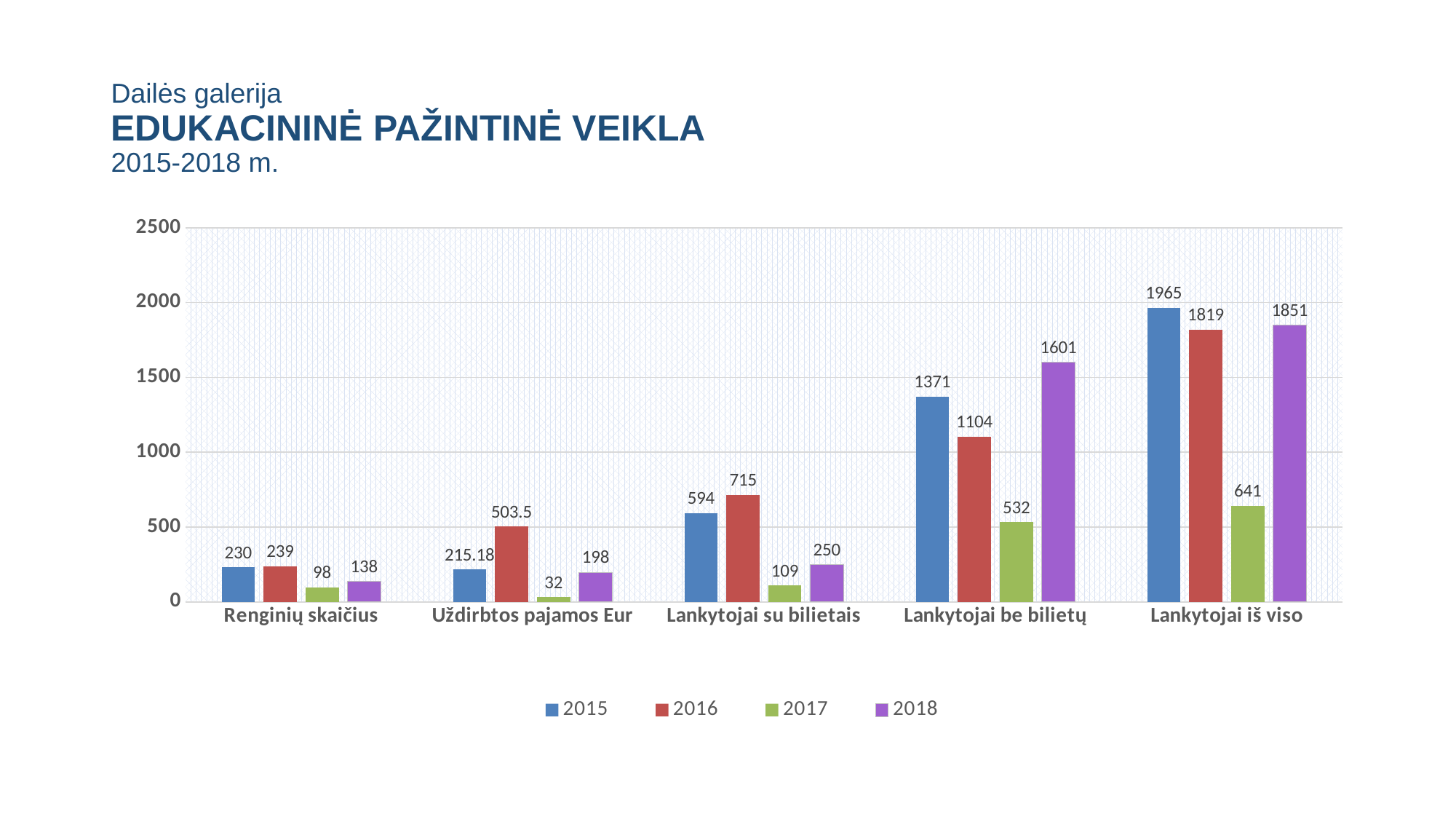
What is the difference between the 2015 and 2016 values in the Lankytojai be bilietų category? 267 How many categories are shown on the x axis? 5 How many series does the legend list? 4 What is the value for 2016 in the Uždirbtos pajamos Eur category? 503.5 Which colour represents the 2017 series in the legend? green Which year has the highest value in the Lankytojai iš viso category? 2015 What is the value for 2017 in the Lankytojai su bilietais category? 109 Which year has the lowest value in the Uždirbtos pajamos Eur category? 2017 Which is larger in the Lankytojai su bilietais category: the 2015 value or the 2016 value? 2016 What is the value for 2018 in the Lankytojai be bilietų category? 1601 What kind of chart is shown on the slide? bar chart Is the 2018 value for Lankytojai iš viso greater or less than 1500? greater